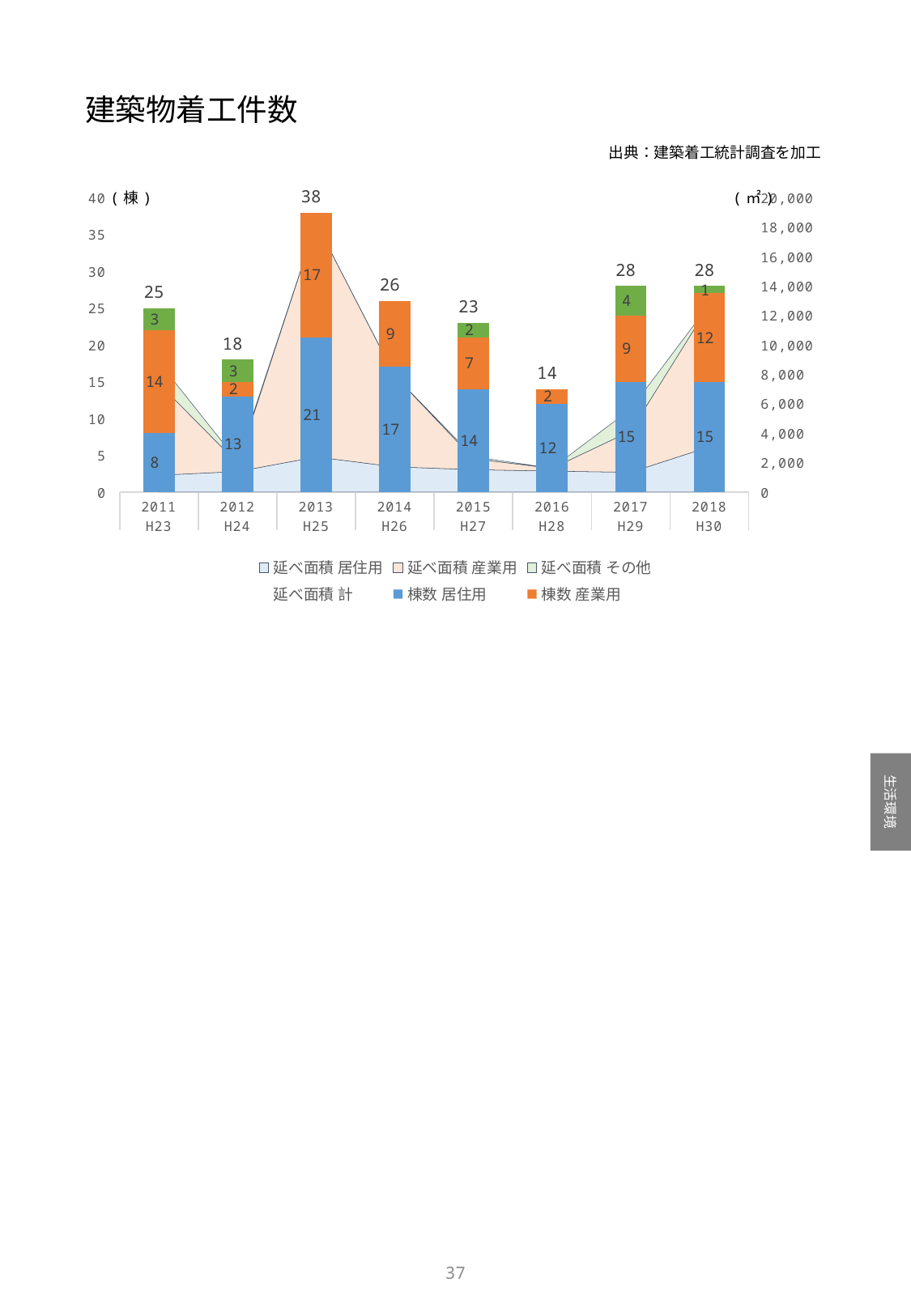
What is the difference between the total for 2013 (H25) and the total for 2016 (H28)? 24 What is the value of 棟数 居住用 for 2014 (H26)? 17 In 2017 (H29), how much larger is 棟数 居住用 than 棟数 産業用? 6 What is the total of the stacked bar for 2015 (H27)? 23 How many series does the legend list? 6 How many years are shown on the x axis? 8 Which year has the highest total number of buildings (棟)? 2013 (H25) Which year has a larger total number of buildings, 2011 (H23) or 2012 (H24)? 2011 (H23) Which year has the lowest total number of buildings (棟)? 2016 (H28) What is the value of 棟数 産業用 for 2018 (H30)? 12 What is the total number of buildings (棟) shown above the stacked bar for 2013 (H25)? 38 What is the value of 棟数 産業用 for 2011 (H23)? 14